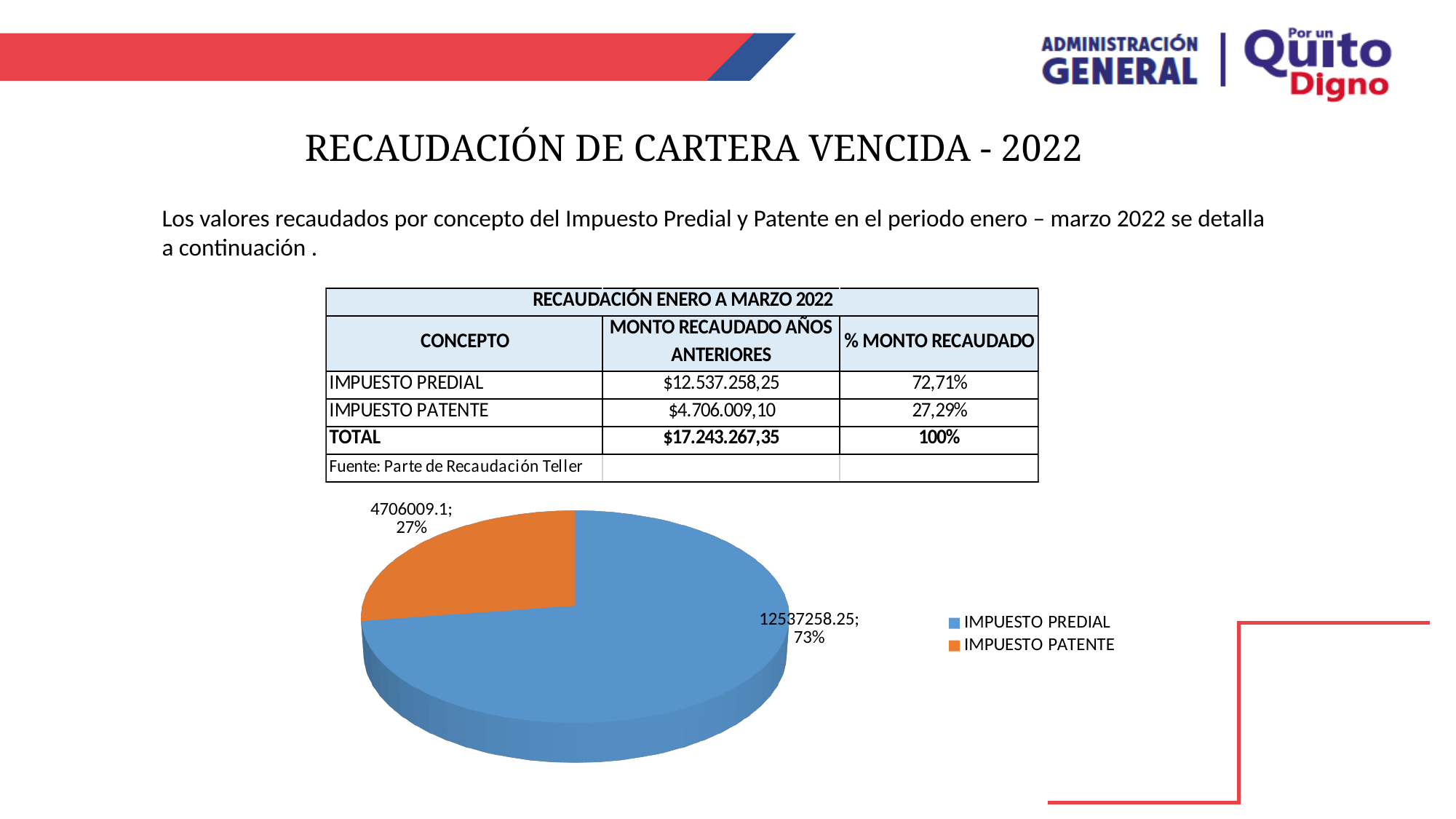
What colour is the IMPUESTO PATENTE slice in the pie chart? orange How many entries does the legend of the pie chart list? 2 What percentage share of the pie does IMPUESTO PATENTE have? 27% What percentage share of the pie does IMPUESTO PREDIAL have? 73% What value is shown for IMPUESTO PREDIAL in the pie chart? 12537258.25 How many slices does the pie chart have? 2 Which is larger in the pie chart, IMPUESTO PREDIAL or IMPUESTO PATENTE? IMPUESTO PREDIAL What kind of chart is shown on the slide? pie chart What colour is the IMPUESTO PREDIAL slice in the pie chart? blue Which category has the largest slice in the pie chart? IMPUESTO PREDIAL Which category has the smallest slice in the pie chart? IMPUESTO PATENTE What value is shown for IMPUESTO PATENTE in the pie chart? 4706009.1